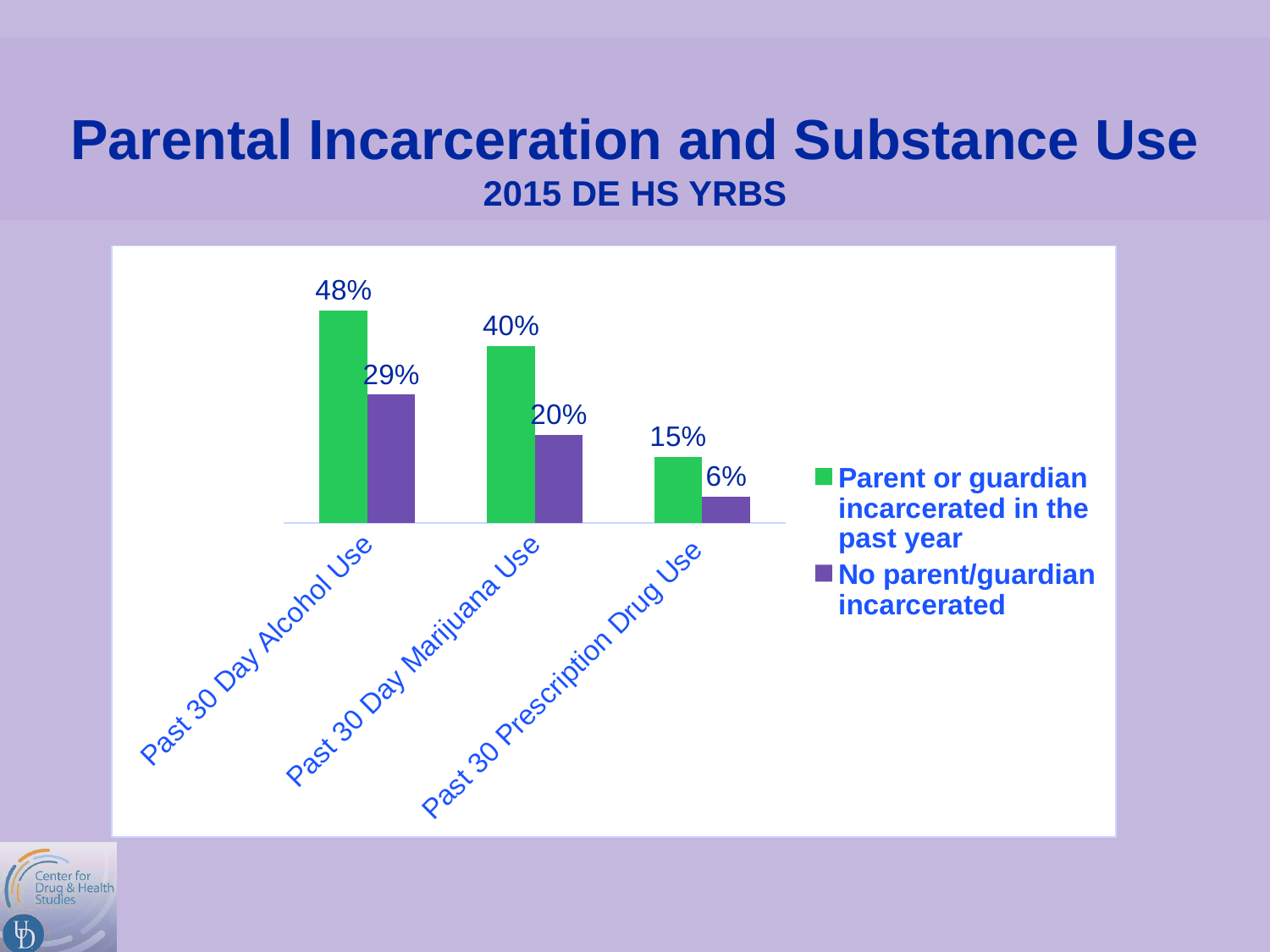
What is the value for Past 30 Day Alcohol Use among students with no parent/guardian incarcerated? 29% What is the difference between the two series for Past 30 Day Marijuana Use? 20% Which category has the highest value for the 'Parent or guardian incarcerated in the past year' series? Past 30 Day Alcohol Use How many substance use categories are shown on the x axis? 3 Which category has the lowest value for the 'No parent/guardian incarcerated' series? Past 30 Prescription Drug Use What kind of chart is shown on the slide? Bar chart What is the value for Past 30 Prescription Drug Use among students with a parent or guardian incarcerated in the past year? 15% What is the difference between the two series for Past 30 Prescription Drug Use? 9% What is the value for Past 30 Day Marijuana Use among students with no parent/guardian incarcerated? 20% How many series does the legend list? 2 For Past 30 Day Alcohol Use, which series has the larger value? Parent or guardian incarcerated in the past year What is the value for Past 30 Day Alcohol Use among students with a parent or guardian incarcerated in the past year? 48%